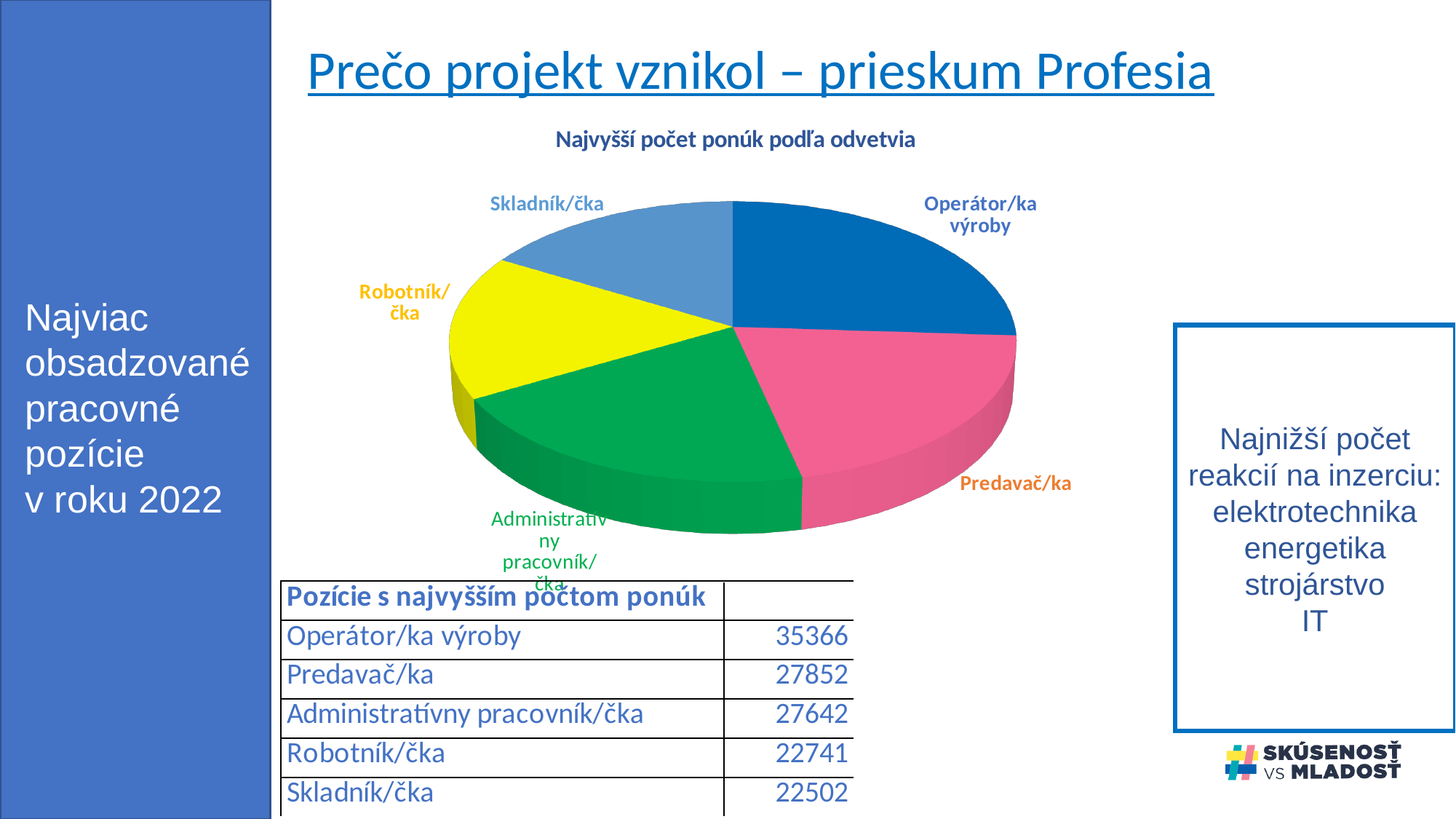
What is the title of the pie chart? Najvyšší počet ponúk podľa odvetvia What type of chart is shown on the slide? pie chart What is the difference in offers between Operátor/ka výroby and Skladník/čka? 12864 According to the table below the chart, how many offers are there for Robotník/čka? 22741 Which position has the lowest number of offers in the pie chart? Skladník/čka What colour is the Robotník/čka slice in the pie chart? yellow According to the table below the chart, how many offers are there for Operátor/ka výroby? 35366 Which position has the highest number of offers in the pie chart? Operátor/ka výroby According to the table below the chart, how many offers are there for Skladník/čka? 22502 What is the difference in offers between Operátor/ka výroby and Predavač/ka? 7514 How many slices does the pie chart have? 5 Which has more offers, Predavač/ka or Robotník/čka? Predavač/ka